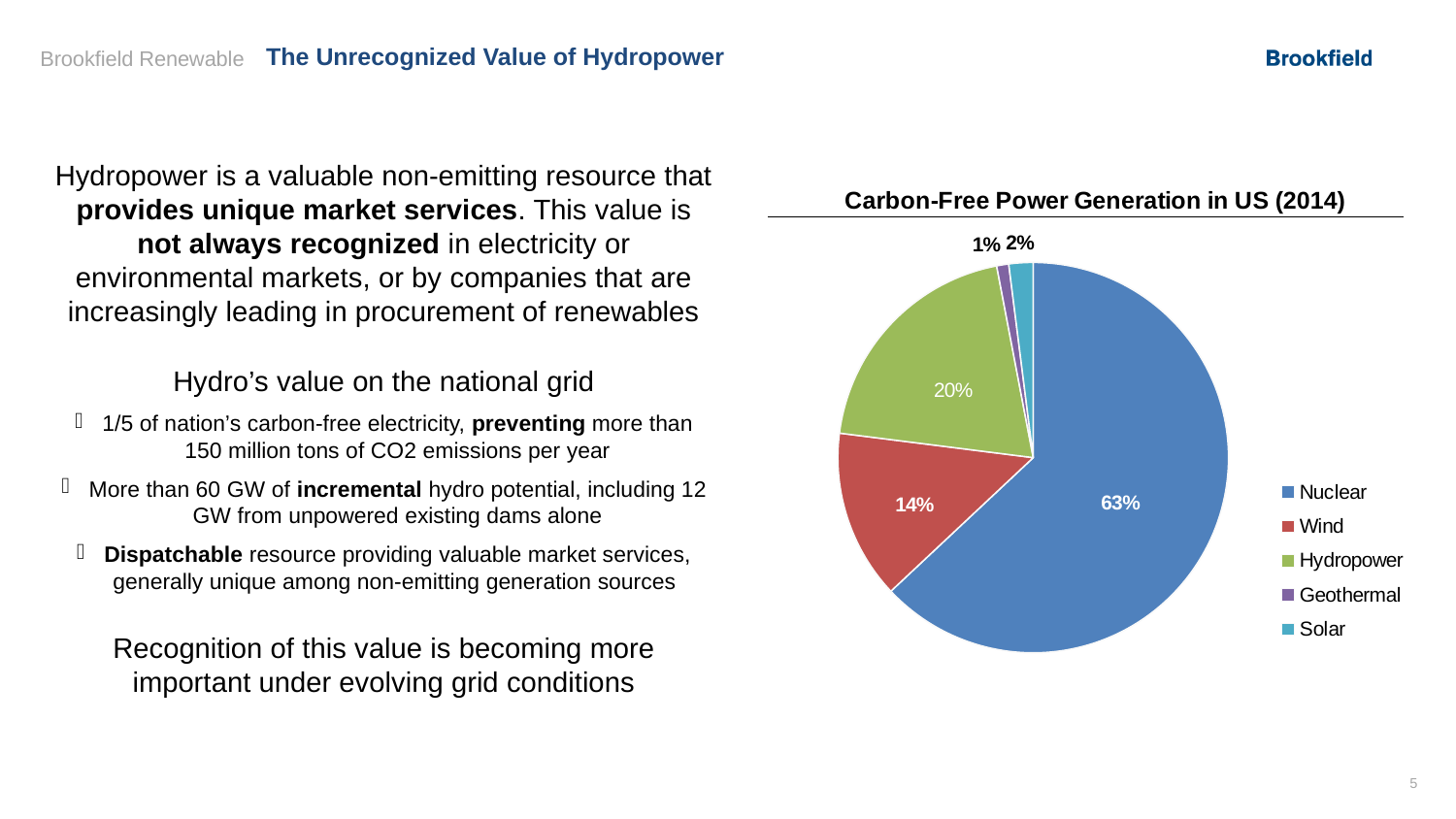
Which source has the smallest share of carbon-free power generation? Geothermal What share of carbon-free power generation does Nuclear account for? 63% Which source has the largest share of carbon-free power generation? Nuclear How many sources are shown in the pie chart legend? 5 What share of carbon-free power generation does Solar account for? 2% What kind of chart is shown on the slide? pie chart What is the title of the chart? Carbon-Free Power Generation in US (2014) What share of carbon-free power generation does Geothermal account for? 1% What share of carbon-free power generation does Wind account for? 14% Which has a larger share, Wind or Hydropower? Hydropower What share of carbon-free power generation does Hydropower account for? 20% What is the difference in percentage points between the Nuclear and Hydropower shares? 43